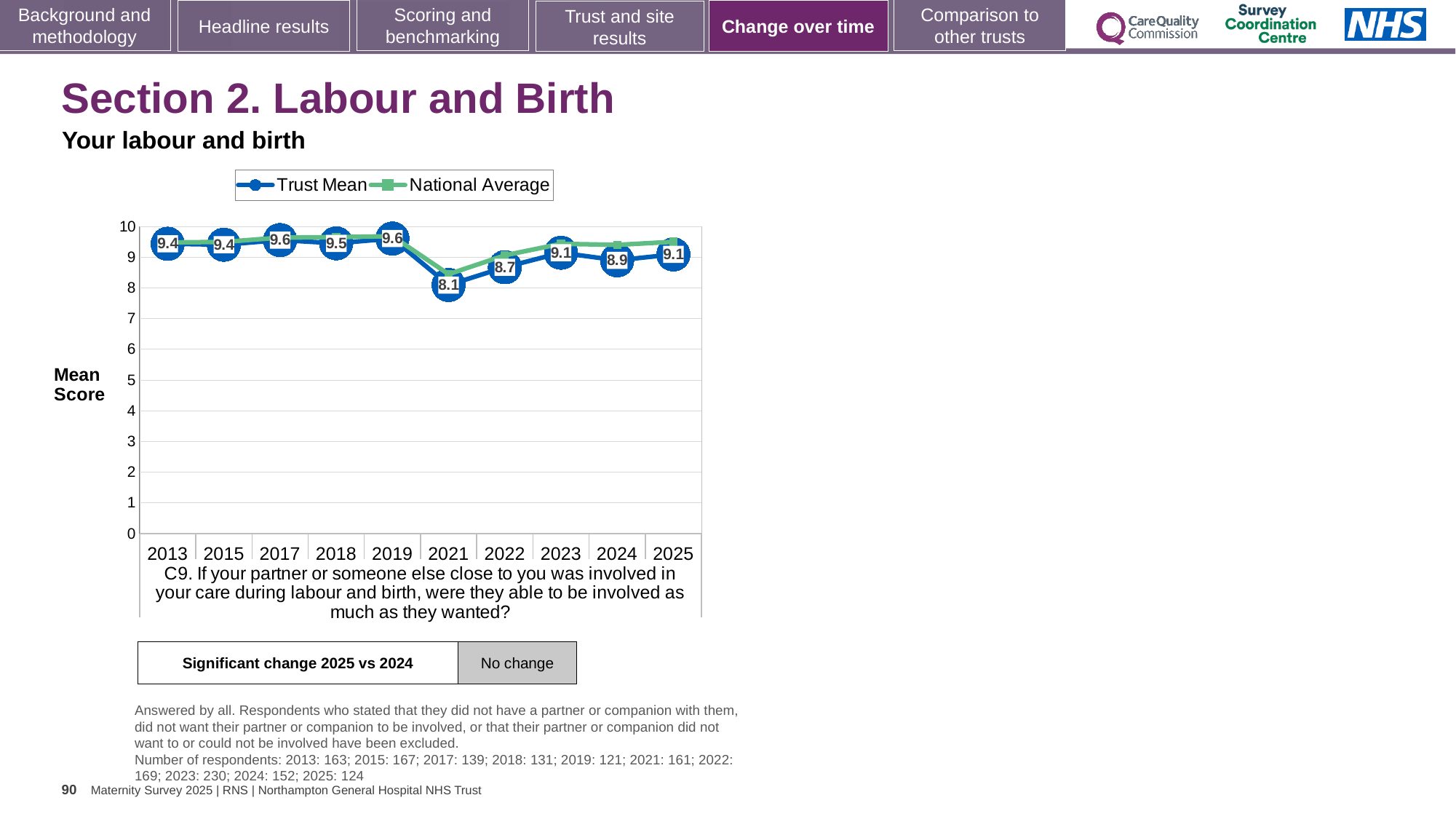
Does the Trust Mean score rise or fall between 2019 and 2021? fall What is the Trust Mean score for 2021? 8.1 In which year is the Trust Mean score lowest? 2021 What are the two series named in the legend? Trust Mean and National Average Is the National Average value for 2021 greater or less than 9? less How many years are plotted on the x axis? 10 What is the Trust Mean score for 2018? 9.5 What kind of chart is shown on the slide? line chart What is the difference between the Trust Mean scores for 2019 and 2021? 1.5 What is the Trust Mean score for 2025? 9.1 How many series does the legend list? 2 Which is larger, the Trust Mean score for 2023 or for 2024? 2023